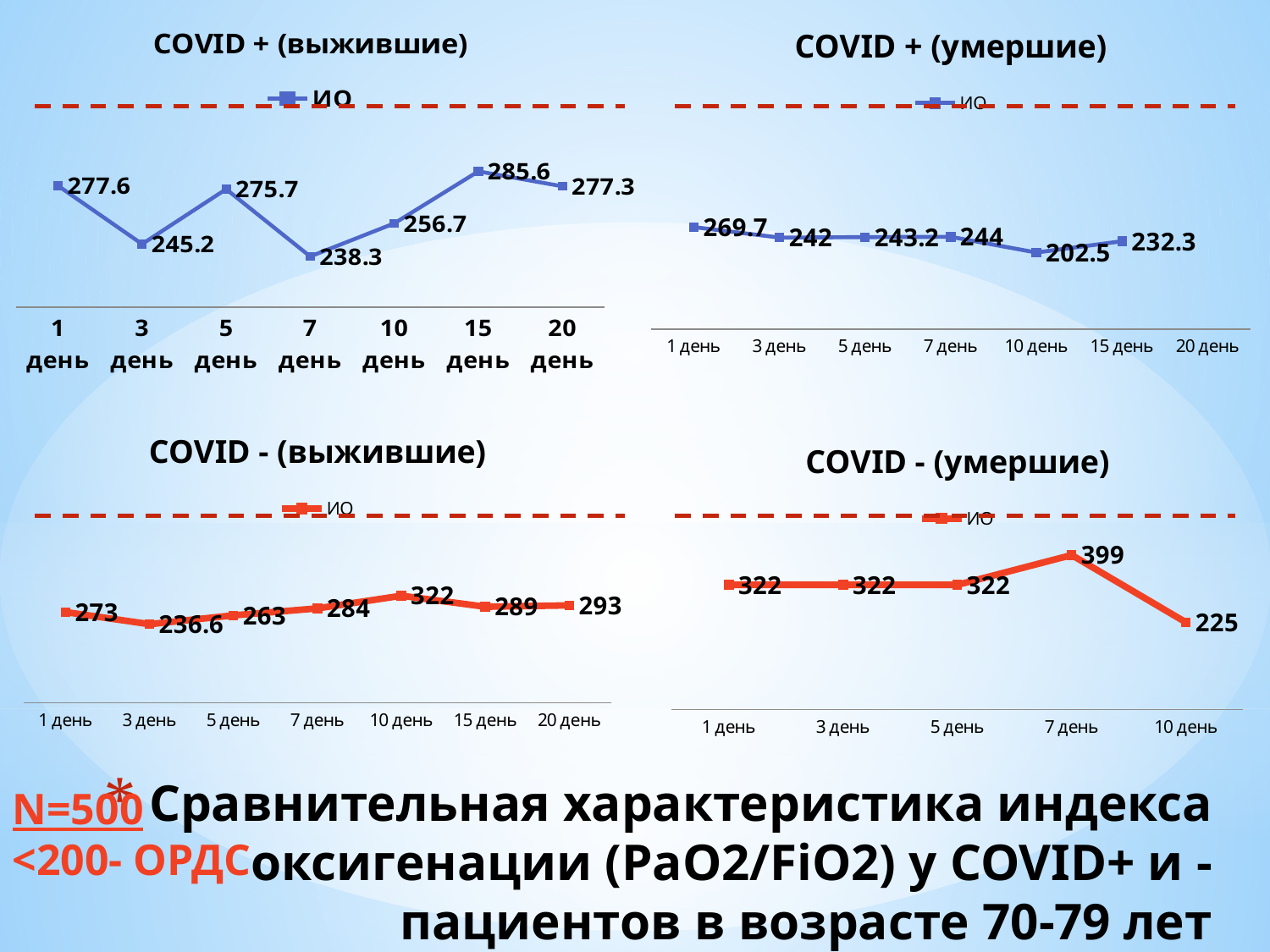
How many days are shown on the x axis of the 'COVID - (умершие)' chart? 5 In the 'COVID + (выжившие)' chart, what is the difference between the values for 15 день and 7 день? 47.3 In the 'COVID + (выжившие)' chart, which day has the lowest value? 7 день In the 'COVID - (выжившие)' chart, is the value for 20 день larger or smaller than the value for 15 день? larger In the 'COVID + (умершие)' chart, what is the value for 10 день? 202.5 In the 'COVID + (выжившие)' chart, what is the value for 15 день? 285.6 In the 'COVID + (умершие)' chart, which day has the highest value? 1 день In the 'COVID - (умершие)' chart, what is the difference between the values for 7 день and 10 день? 174 In the 'COVID - (умершие)' chart, what is the value for 7 день? 399 In the 'COVID - (выжившие)' chart, which day has the highest value? 10 день What type of chart is the 'COVID + (выжившие)' chart? line chart In the 'COVID - (выжившие)' chart, what is the value for 3 день? 236.6